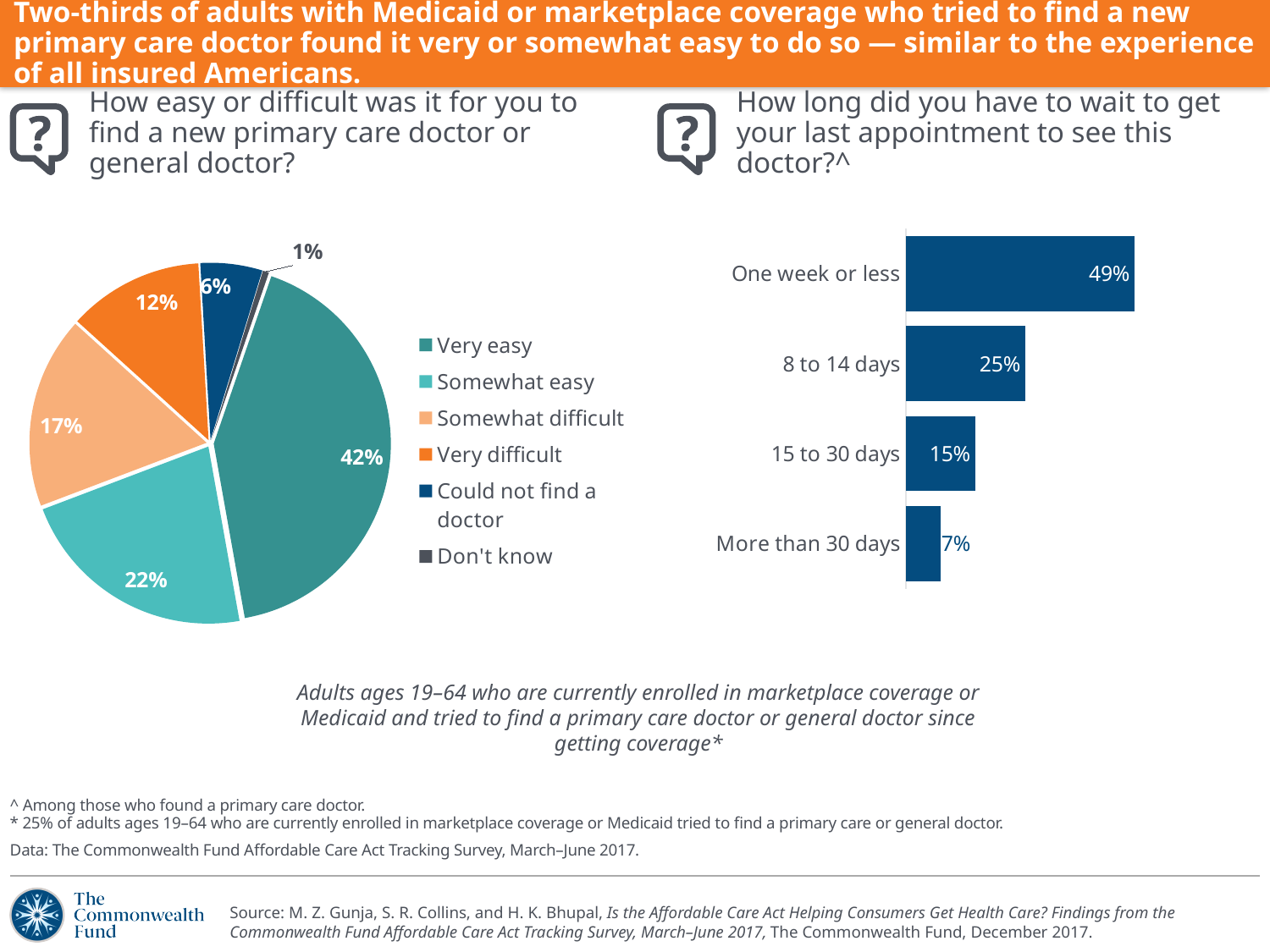
In the bar chart on the right, what is the difference between the share who waited one week or less and the share who waited 8 to 14 days? 24 percentage points In the pie chart on the left, how many response categories does the legend list? 6 In the pie chart on the left, what percentage of adults could not find a doctor? 6% In the pie chart on the left, what share of adults said it was very easy to find a new primary care doctor? 42% In the bar chart on the right, what percentage of adults waited one week or less for their last appointment? 49% In the pie chart on the left, what is the combined share of adults who found it very easy or somewhat easy? 64% In the bar chart on the right, what percentage of adults waited more than 30 days? 7% What type of chart is shown on the right side of the slide? Bar chart In the pie chart on the left, which is larger: the share for somewhat difficult or the share for very difficult? Somewhat difficult In the pie chart on the left, which response has the largest slice? Very easy In the pie chart on the left, which response has the smallest slice? Don't know In the bar chart on the right, how many wait-time categories are shown? 4